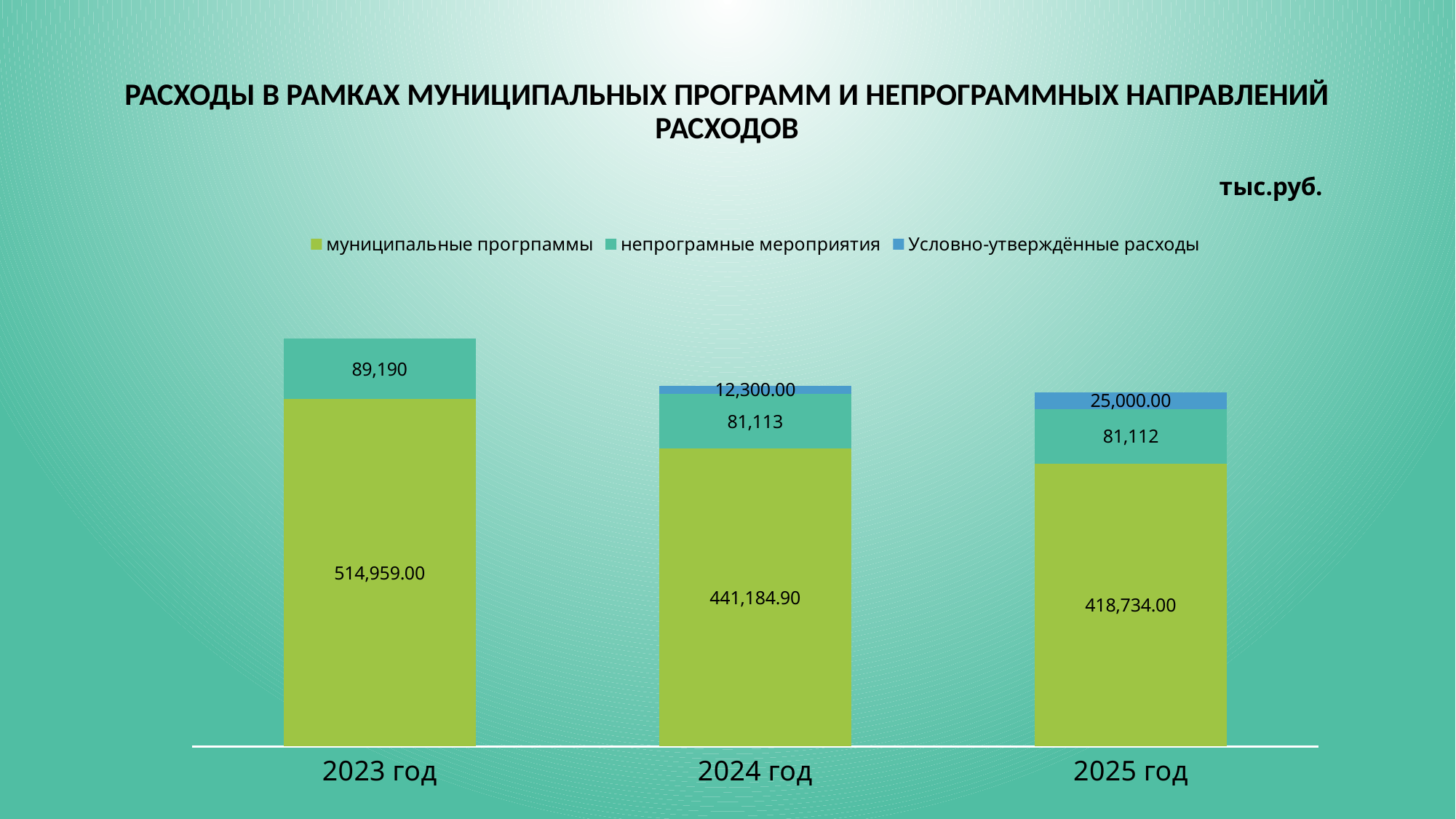
In which year is the value for муниципальные прогрпаммы the lowest? 2025 год What is the difference between the Условно-утверждённые расходы values for 2025 год and 2024 год? 12,700.00 How many series does the legend list? 3 What is the total of the stacked bar for 2024 год? 534,597.90 How many years are shown on the x axis? 3 What kind of chart is shown on the slide? Stacked bar chart What is the value for муниципальные прогрпаммы in 2023 год? 514,959.00 What is the value for Условно-утверждённые расходы in 2025 год? 25,000.00 What is the difference between the муниципальные прогрпаммы values for 2023 год and 2024 год? 73,774.10 Which is larger: непрограмные мероприятия in 2023 год or in 2025 год? 2023 год In which year is the value for муниципальные прогрпаммы the highest? 2023 год What is the value for непрограмные мероприятия in 2024 год? 81,113